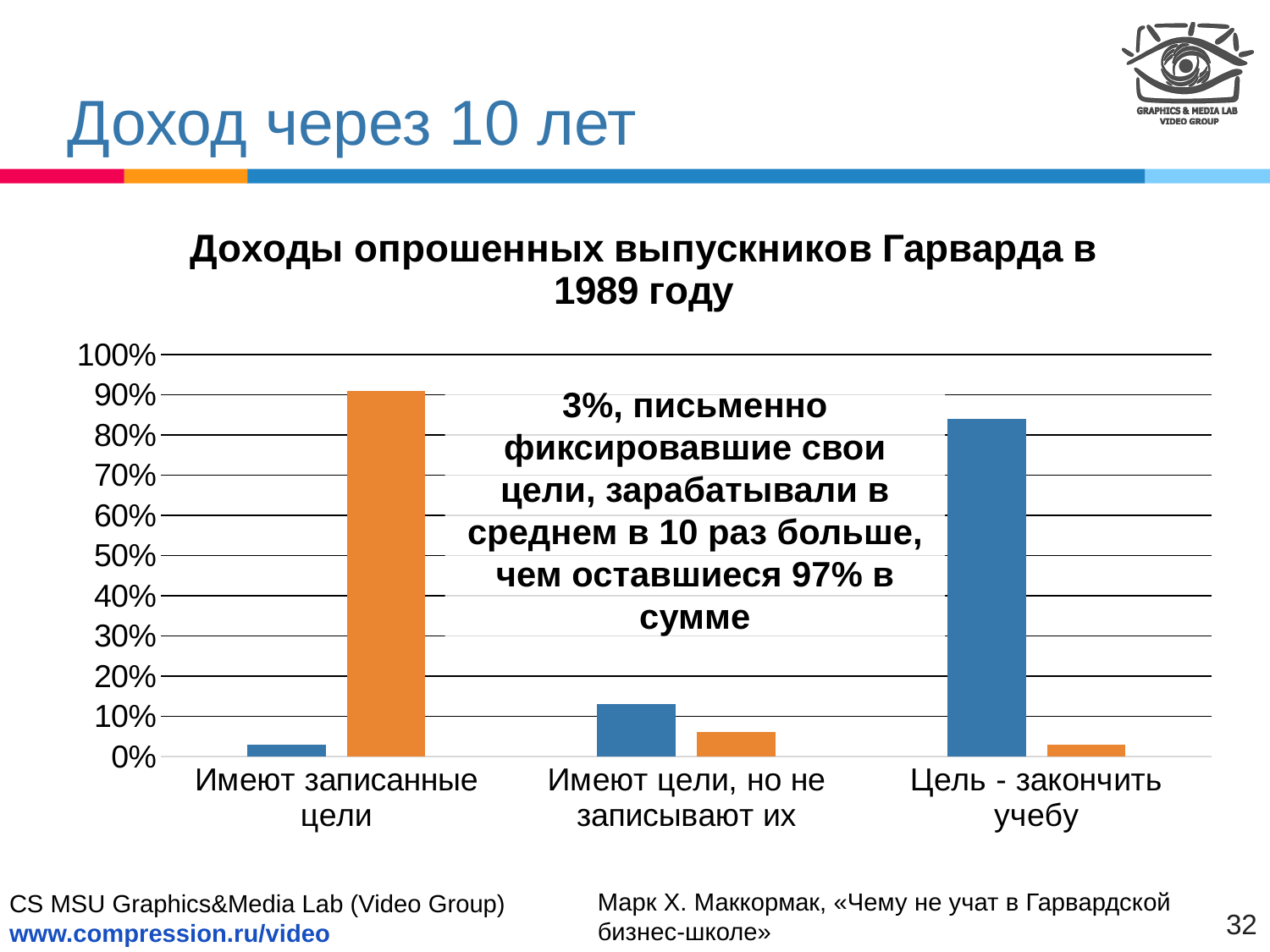
How many categories are shown on the x axis of the chart? 3 Is the orange bar for "Имеют записанные цели" greater or less than 80%? greater In the category "Цель - закончить учебу", which bar is taller, the blue one or the orange one? Blue Which category has the tallest orange bar? Имеют записанные цели In the category "Имеют записанные цели", which bar is taller, the blue one or the orange one? Orange Is the blue bar for "Цель - закончить учебу" greater or less than 80%? greater What kind of chart is shown on the slide? Bar chart Which category has the tallest blue bar? Цель - закончить учебу Is the blue bar for "Имеют цели, но не записывают их" greater or less than 20%? less Which category has the shortest blue bar? Имеют записанные цели How many bars are plotted for each category in the chart? 2 What is the title of the chart? Доходы опрошенных выпускников Гарварда в 1989 году